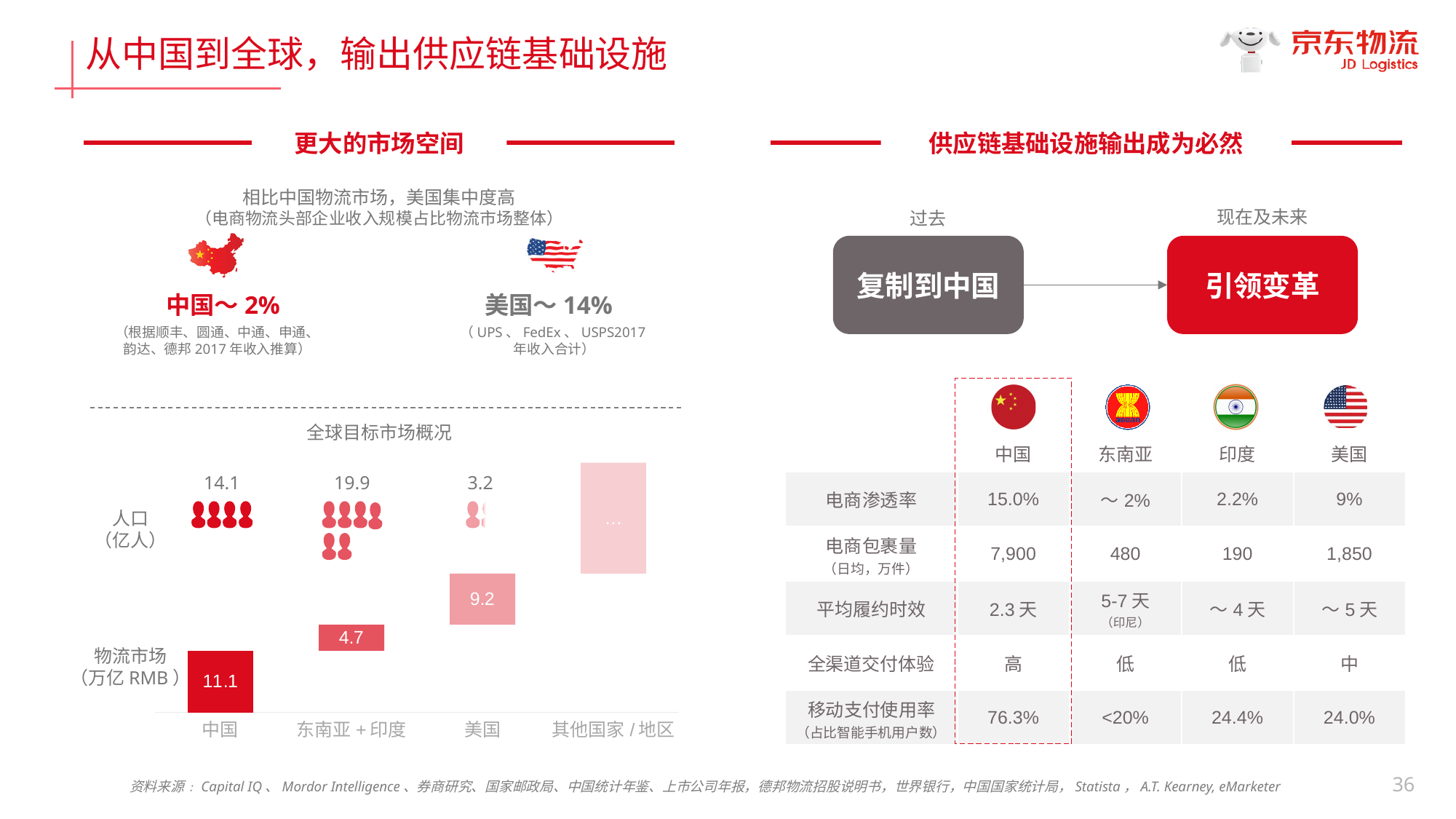
In the 全球目标市场概况 chart, what is the difference between the 物流市场 values of 中国 and 美国? 1.9 In the 全球目标市场概况 chart, what is the 人口 (亿人) value for 美国? 3.2 In the 全球目标市场概况 chart, what is the 物流市场 (万亿 RMB) value for 中国? 11.1 In the 全球目标市场概况 chart, which has the larger 人口 value, 中国 or 东南亚 + 印度? 东南亚 + 印度 In the 全球目标市场概况 chart, what is the 物流市场 (万亿 RMB) value for 美国? 9.2 In the 全球目标市场概况 chart, what is the difference between the 人口 values of 东南亚 + 印度 and 中国? 5.8 In the 全球目标市场概况 chart, what is the 人口 (亿人) value for 东南亚 + 印度? 19.9 In the 全球目标市场概况 chart, which region has the largest 物流市场 value? 中国 In the 全球目标市场概况 chart, which of the labelled regions has the smallest 人口 value? 美国 How many regions are shown along the x axis of the 全球目标市场概况 chart? 4 In the 全球目标市场概况 chart, what is the 物流市场 (万亿 RMB) value for 东南亚 + 印度? 4.7 What kind of chart is used for the 物流市场 (万亿 RMB) row in the 全球目标市场概况 chart? Bar chart